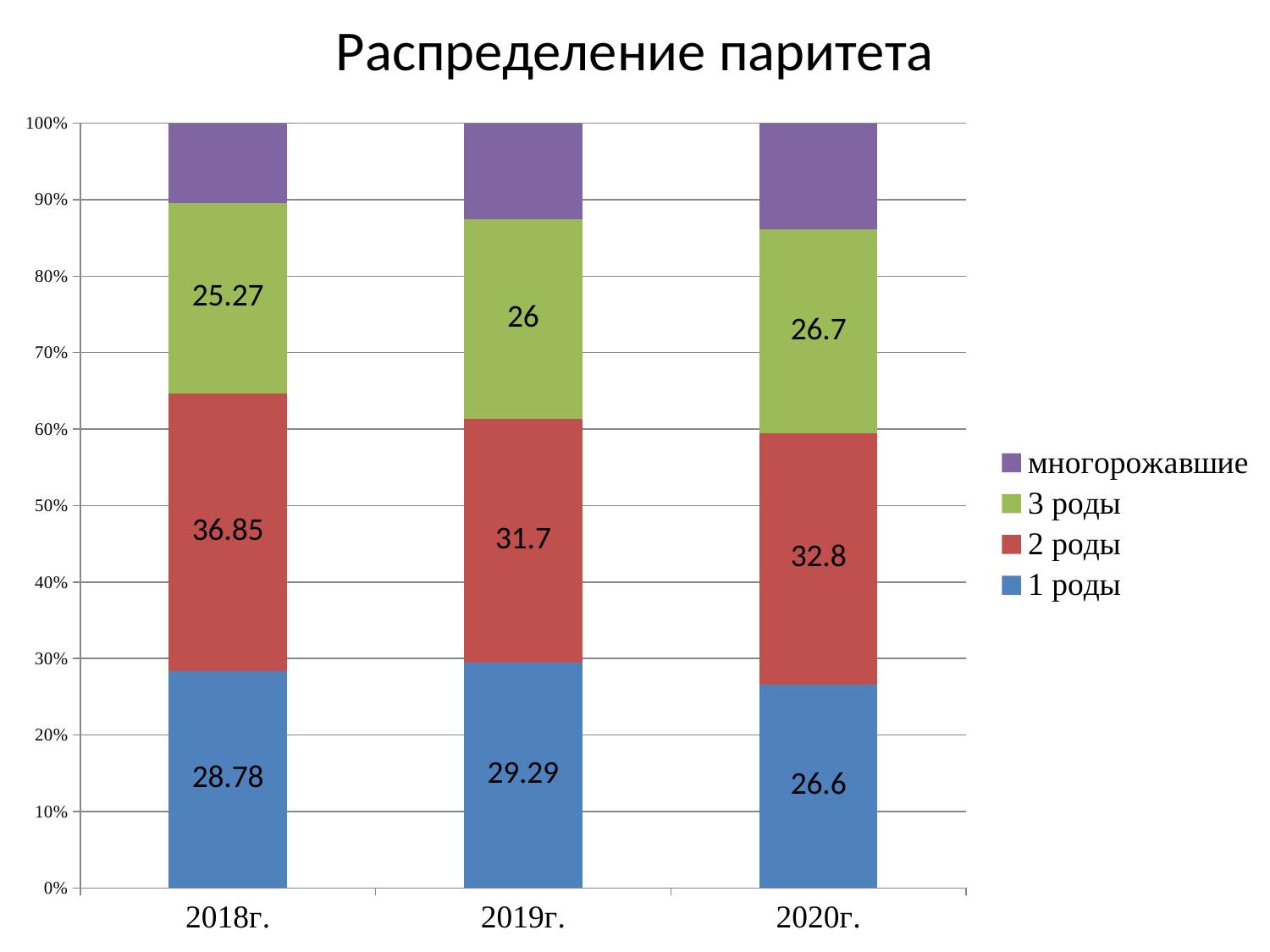
Does the value for 3 роды rise or fall from 2018г. to 2020г.? rise How many series does the legend list? 4 How many years are shown on the x axis? 3 What kind of chart is shown on the slide? stacked bar chart What is the value for 2 роды in 2018г.? 36.85 What is the value for 3 роды in 2019г.? 26 Which is larger in 2020г.: the value for 2 роды or the value for 3 роды? 2 роды What is the value for 1 роды in 2020г.? 26.6 What is the difference between the 2 роды values for 2018г. and 2019г.? 5.15 In which year is the value for 2 роды highest? 2018г. What is the difference between the 1 роды values for 2019г. and 2020г.? 2.69 In which year is the value for 1 роды lowest? 2020г.